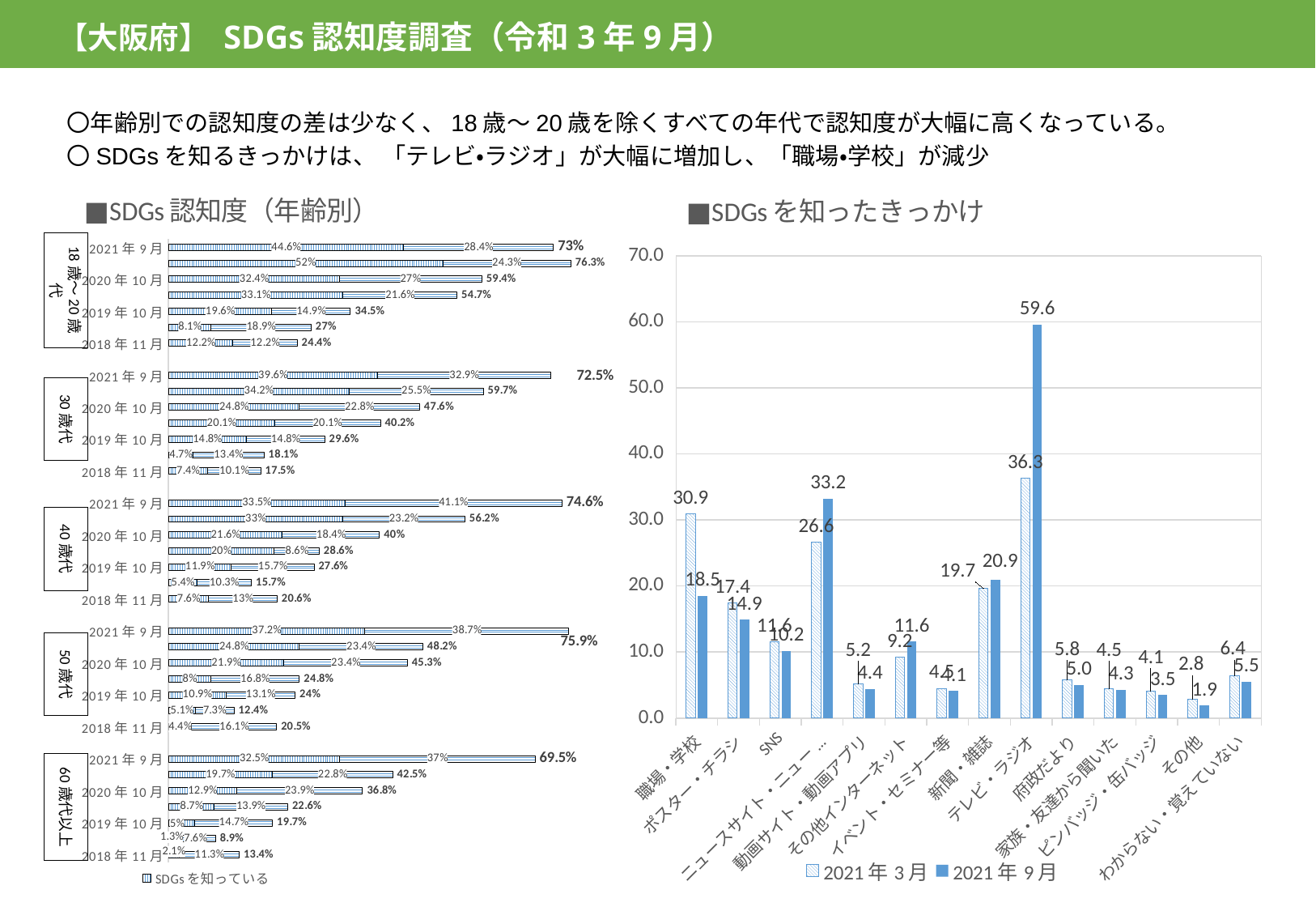
In the 「SDGsを知ったきっかけ」 chart, which category has the lowest value for 2021年9月? その他 In the 「SDGsを知ったきっかけ」 chart, what is the difference between the 2021年9月 and 2021年3月 values for テレビ・ラジオ? 23.3 In the 「SDGs認知度（年齢別）」 chart, which age group has the highest total awareness in 2021年9月? 50歳代 In the 「SDGsを知ったきっかけ」 chart, what is the value for テレビ・ラジオ in 2021年9月? 59.6 In the 「SDGsを知ったきっかけ」 chart, which category has the highest value for 2021年9月? テレビ・ラジオ How many categories are shown on the x axis of the 「SDGsを知ったきっかけ」 chart? 14 What kind of chart is the 「SDGsを知ったきっかけ」 chart? bar chart How many series does the legend of the 「SDGsを知ったきっかけ」 chart list? 2 In the 「SDGsを知ったきっかけ」 chart, for 職場・学校, which series has the larger value, 2021年3月 or 2021年9月? 2021年3月 In the 「SDGs認知度（年齢別）」 chart, what is the total awareness for 40歳代 in 2021年9月? 74.6% In the 「SDGsを知ったきっかけ」 chart, is the 2021年9月 value for SNS greater or less than 20.0? less In the 「SDGsを知ったきっかけ」 chart, what is the value for 職場・学校 in 2021年3月? 30.9